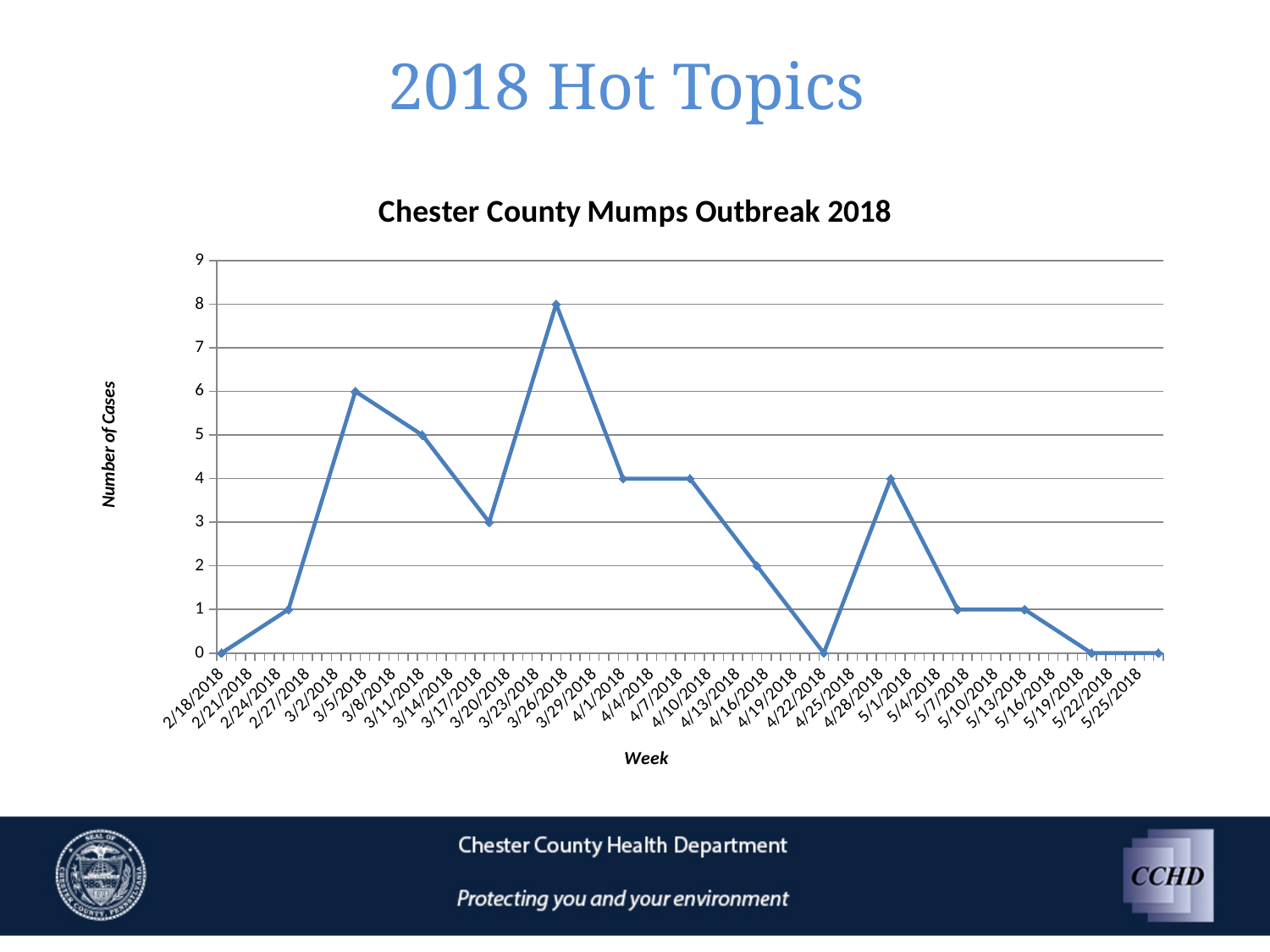
Is the peak value of the line greater or less than 7? greater How many data points are plotted on the line? 15 What kind of chart is shown on the slide? line chart What is the title of the chart? Chester County Mumps Outbreak 2018 What is the difference between the peak value of 8 and the second-highest value of 6? 2 What is the number of cases at the first point, 2/18/2018? 0 How many lines (series) are plotted on the chart? 1 Which is larger, the first peak of the line or the highest peak of the line? the highest peak (8) What is the lowest number of cases shown on the line? 0 What is the highest number of cases reached by the line? 8 After the peak of 8 cases, do the values generally rise or fall toward the end of the x axis? fall What is the label on the vertical axis of the chart? Number of Cases